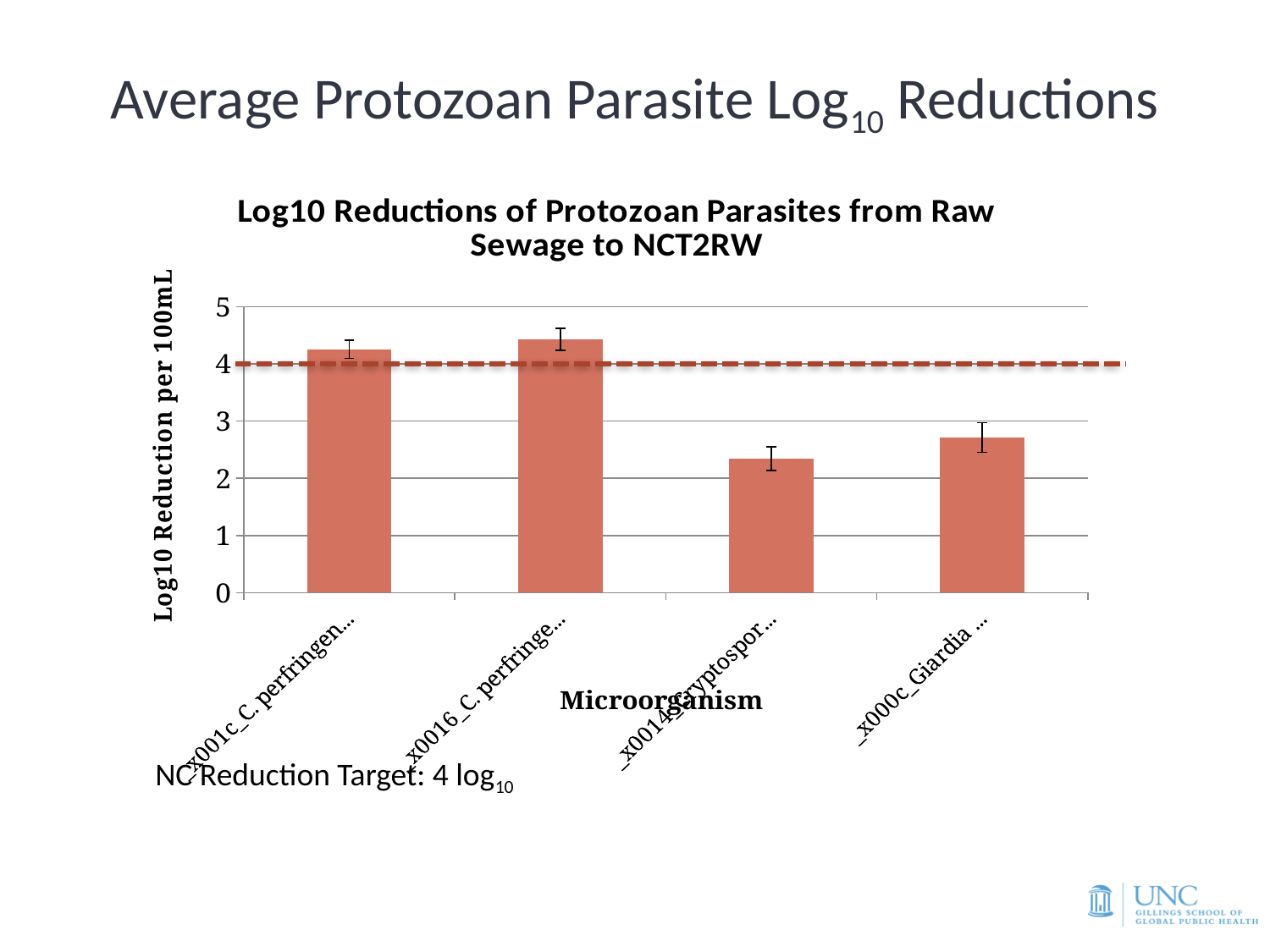
Is the value for the second C. perfringens bar (second from the left) greater or less than 4? greater What is the label of the vertical axis? Log10 Reduction per 100mL How many bars (microorganism categories) are plotted in the chart? 4 Is the value for the Giardia bar greater or less than 2? greater Which is larger, the value for the leftmost C. perfringens bar or the value for Cryptosporidium? The leftmost C. perfringens bar Which is larger, the value for Giardia or the value for Cryptosporidium? Giardia Is the value for the Giardia bar greater or less than 3? less What kind of chart is shown on the slide? Bar chart Which bar has the lowest log10 reduction? Cryptosporidium How many bars exceed the dashed horizontal line at 4? 2 What is the title of the chart? Log10 Reductions of Protozoan Parasites from Raw Sewage to NCT2RW